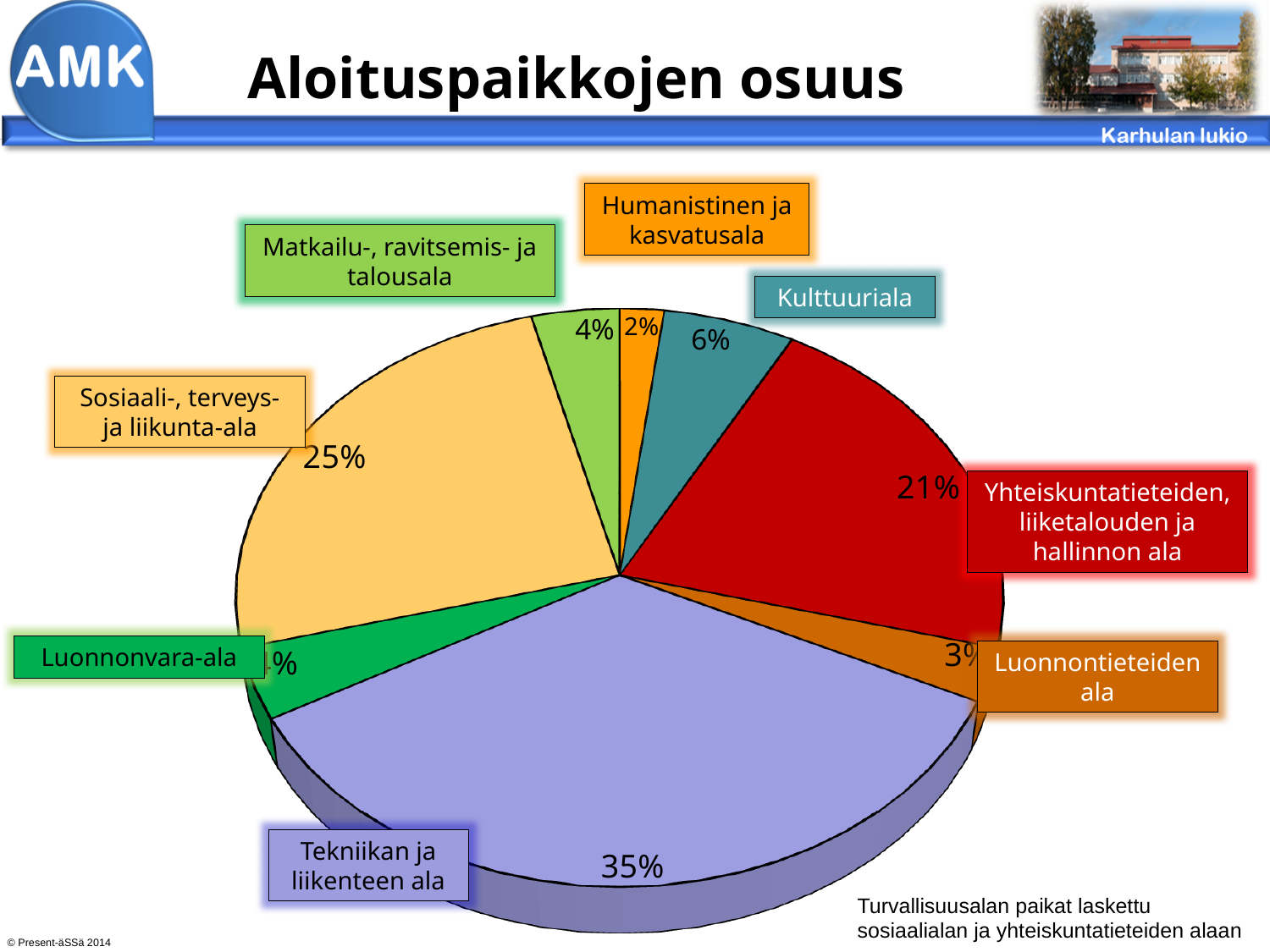
Which sector has the smallest share of the pie? Humanistinen ja kasvatusala What share of the pie does Sosiaali-, terveys- ja liikunta-ala have? 25% What share of the pie does Humanistinen ja kasvatusala have? 2% What share of the pie does Tekniikan ja liikenteen ala have? 35% What share of the pie does Matkailu-, ravitsemis- ja talousala have? 4% What share of the pie does Kulttuuriala have? 6% Which has a larger share: Sosiaali-, terveys- ja liikunta-ala or Yhteiskuntatieteiden, liiketalouden ja hallinnon ala? Sosiaali-, terveys- ja liikunta-ala Which sector has the largest share of the pie? Tekniikan ja liikenteen ala What kind of chart is shown on the slide? Pie chart What share of the pie does Yhteiskuntatieteiden, liiketalouden ja hallinnon ala have? 21% How many percentage points larger is the share of Tekniikan ja liikenteen ala than that of Sosiaali-, terveys- ja liikunta-ala? 10 What is the title of the chart? Aloituspaikkojen osuus